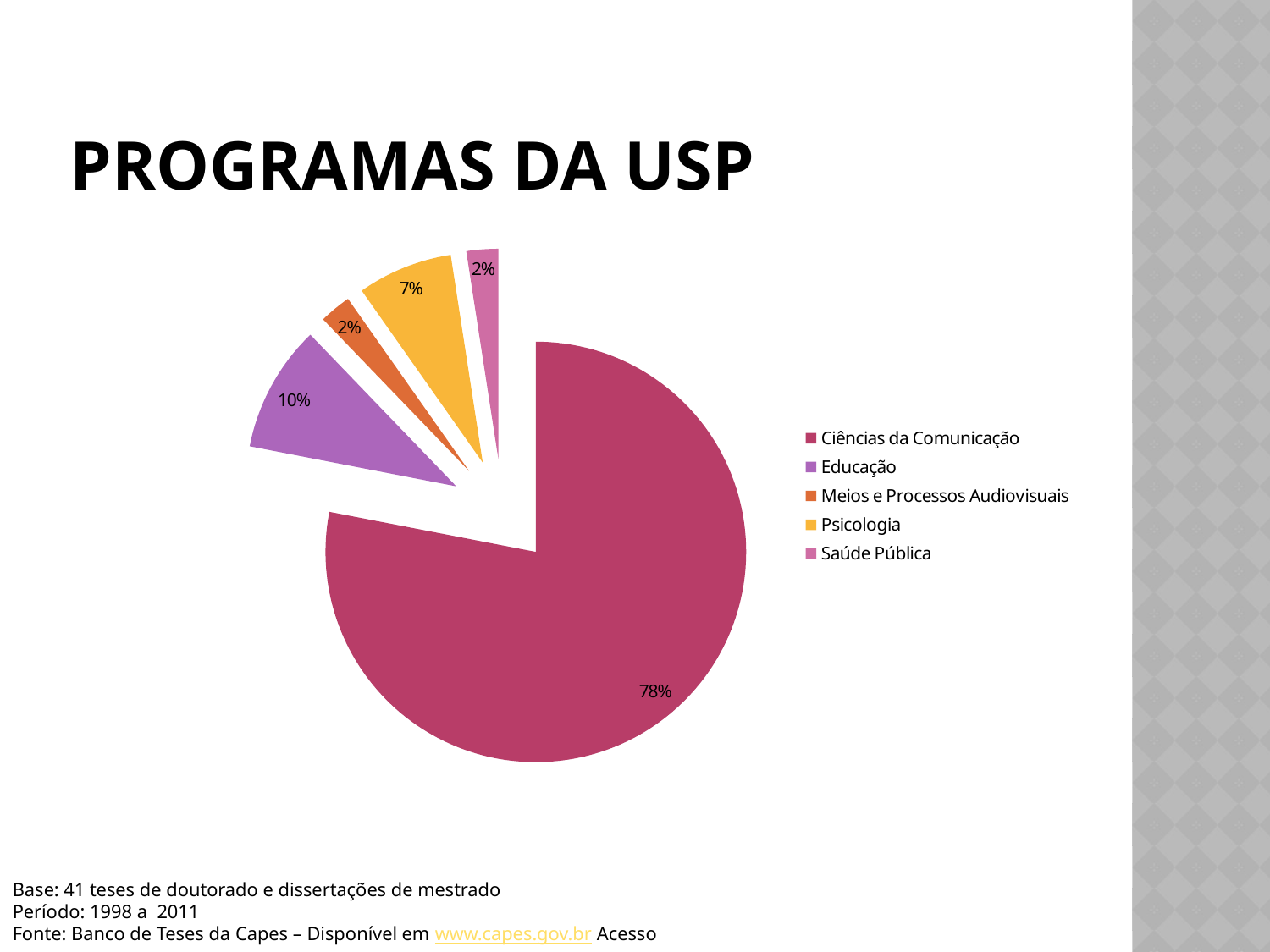
What is the difference in percentage points between Psicologia and Saúde Pública? 5 What share of the pie does Educação hold? 10% What share of the pie does Meios e Processos Audiovisuais hold? 2% How many categories does the pie chart show? 5 What share of the pie does Ciências da Comunicação hold? 78% What is the title of the slide containing the pie chart? PROGRAMAS DA USP Which is larger, the slice for Educação or the slice for Psicologia? Educação Which category has the largest slice of the pie? Ciências da Comunicação What is the difference in percentage points between Ciências da Comunicação and Educação? 68 What kind of chart is shown on the slide? pie chart